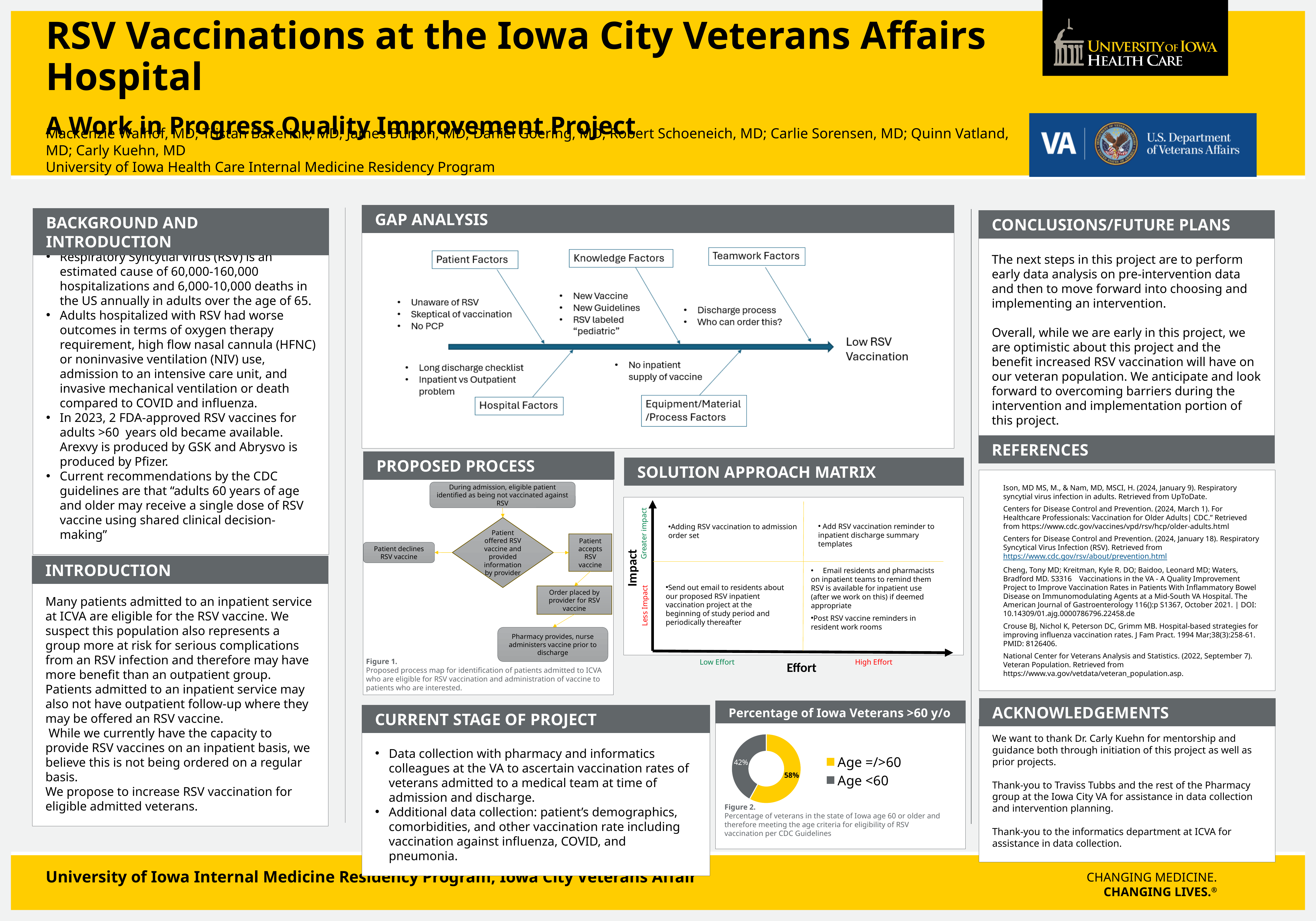
In the "Percentage of Iowa Veterans >60 y/o" chart, what is the difference in percentage points between Age =/>60 and Age <60? 16 What kind of chart is shown under the title "Percentage of Iowa Veterans >60 y/o"? doughnut chart In the "Percentage of Iowa Veterans >60 y/o" chart, what percentage is shown for Age <60? 42% In the "Percentage of Iowa Veterans >60 y/o" chart, what percentage is shown for Age =/>60? 58% In the "Percentage of Iowa Veterans >60 y/o" chart, which category has the smaller share? Age <60 In the "Percentage of Iowa Veterans >60 y/o" chart, what colour represents Age <60? gray What is the title of the chart on the slide? Percentage of Iowa Veterans >60 y/o How many categories does the legend of the "Percentage of Iowa Veterans >60 y/o" chart list? 2 In the "Percentage of Iowa Veterans >60 y/o" chart, what share of the whole does the Age =/>60 slice represent? 58% In the "Percentage of Iowa Veterans >60 y/o" chart, is the share for Age =/>60 larger or smaller than the share for Age <60? larger In the "Percentage of Iowa Veterans >60 y/o" chart, which category has the larger share? Age =/>60